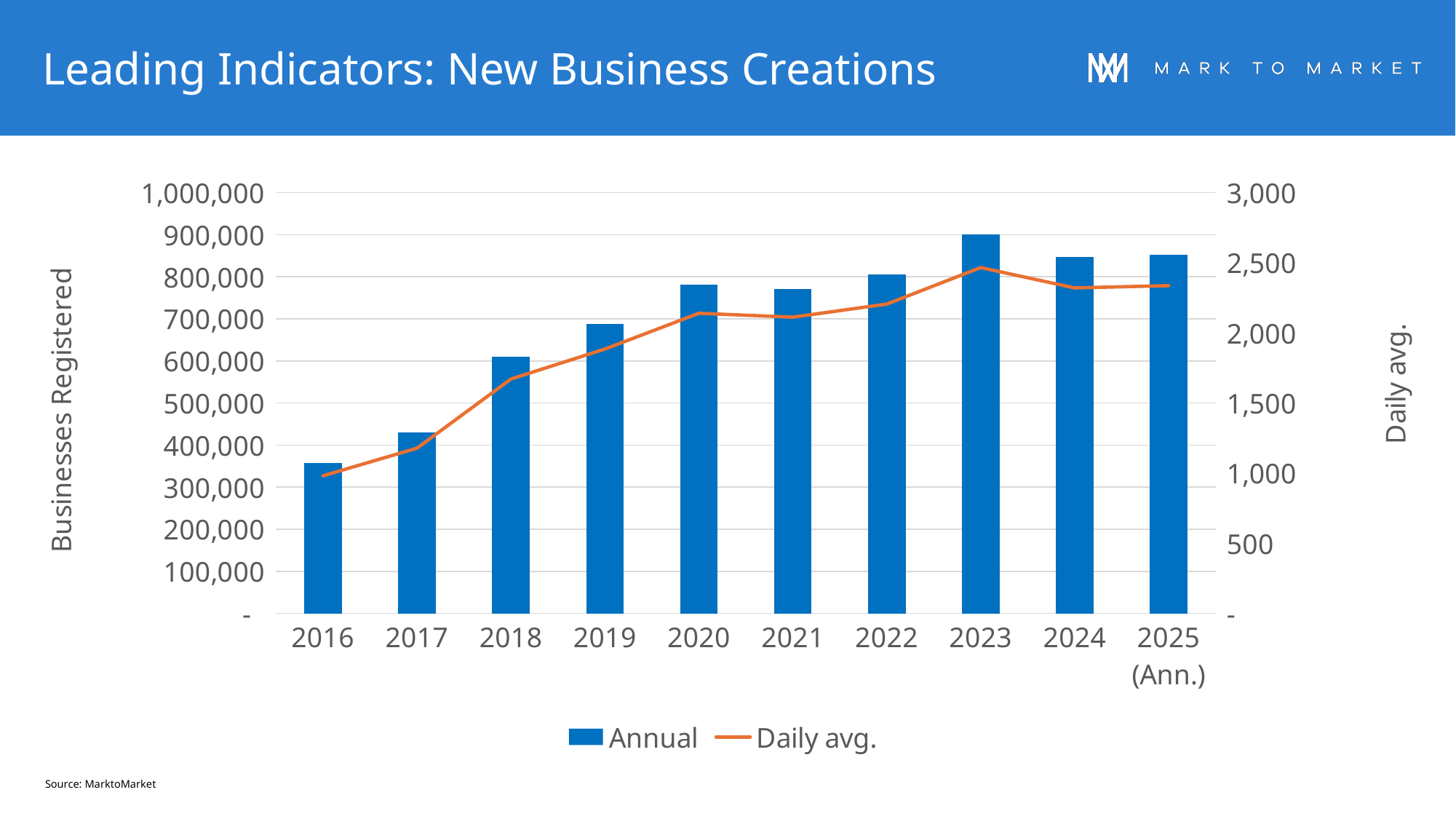
Is the Annual value for 2023 greater or less than 800,000? greater Is the Annual value for 2020 greater or less than 700,000? greater Which year has the lowest Annual value? 2016 Is the Daily avg. value for 2023 greater or less than 2,000? greater Which is larger, the Annual value for 2018 or for 2019? 2019 Which year has the highest Annual value? 2023 What kind of chart is this? Combination bar and line chart What is the title of the left vertical axis? Businesses Registered How many years are shown on the x axis? 10 How many series does the legend list? 2